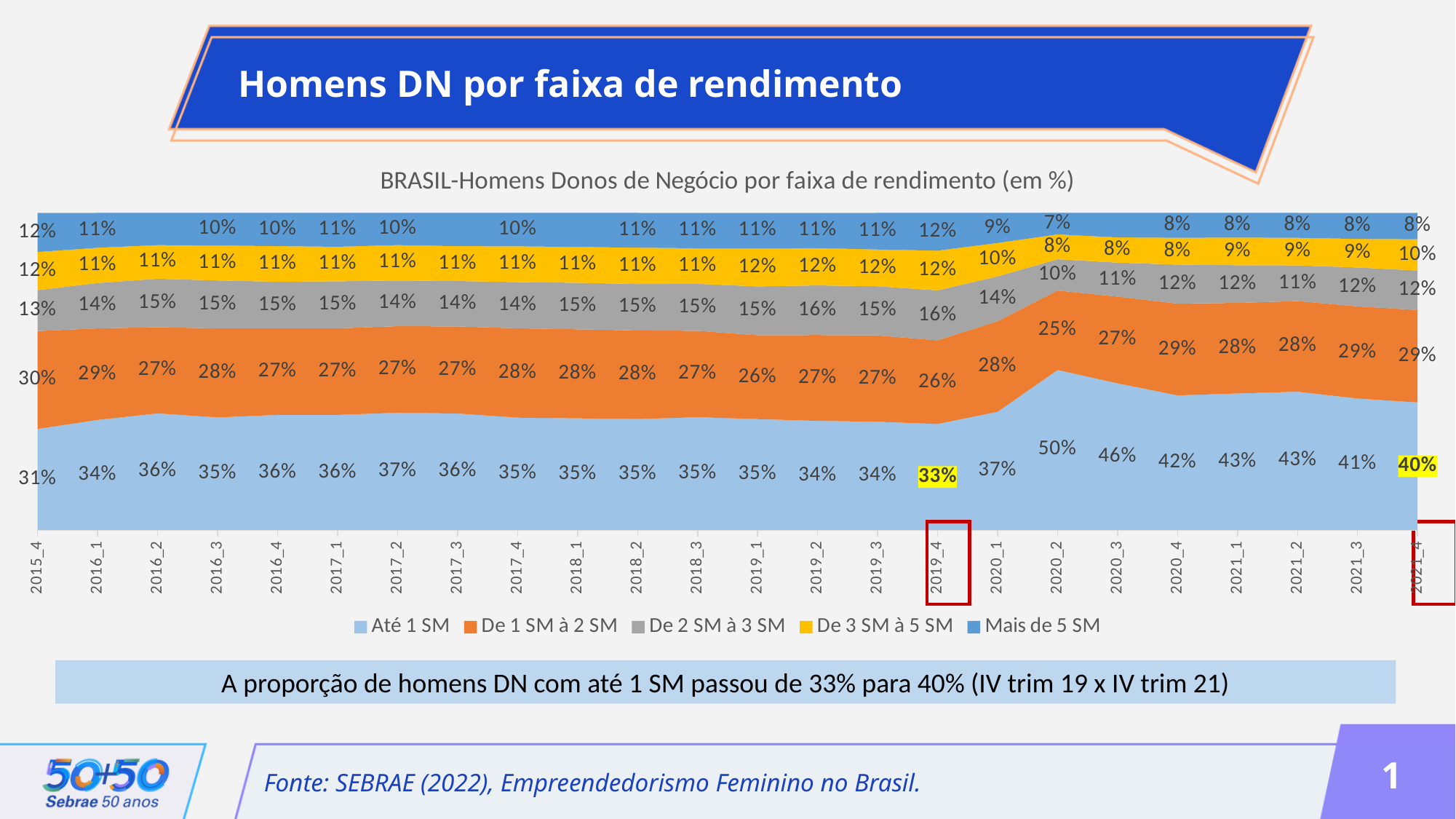
What is the value for 'Mais de 5 SM' in 2021_4? 8% In which period is the 'Até 1 SM' share lowest? 2015_4 Which is larger in 2020_2: 'De 1 SM à 2 SM' or 'De 2 SM à 3 SM'? De 1 SM à 2 SM What is the title of the chart? BRASIL-Homens Donos de Negócio por faixa de rendimento (em %) In which period is the 'Até 1 SM' share highest? 2020_2 What kind of chart is shown on the slide? Stacked area chart How many time periods are shown along the x axis? 24 By how many percentage points did the 'Até 1 SM' share change from 2019_4 to 2021_4? 7 percentage points (33% to 40%) Did the 'Mais de 5 SM' share rise or fall from 2019_4 to 2020_2? Fall How many series does the legend list? 5 What is the value for 'De 1 SM à 2 SM' in 2015_4? 30% What is the value for 'Até 1 SM' in 2020_2? 50%